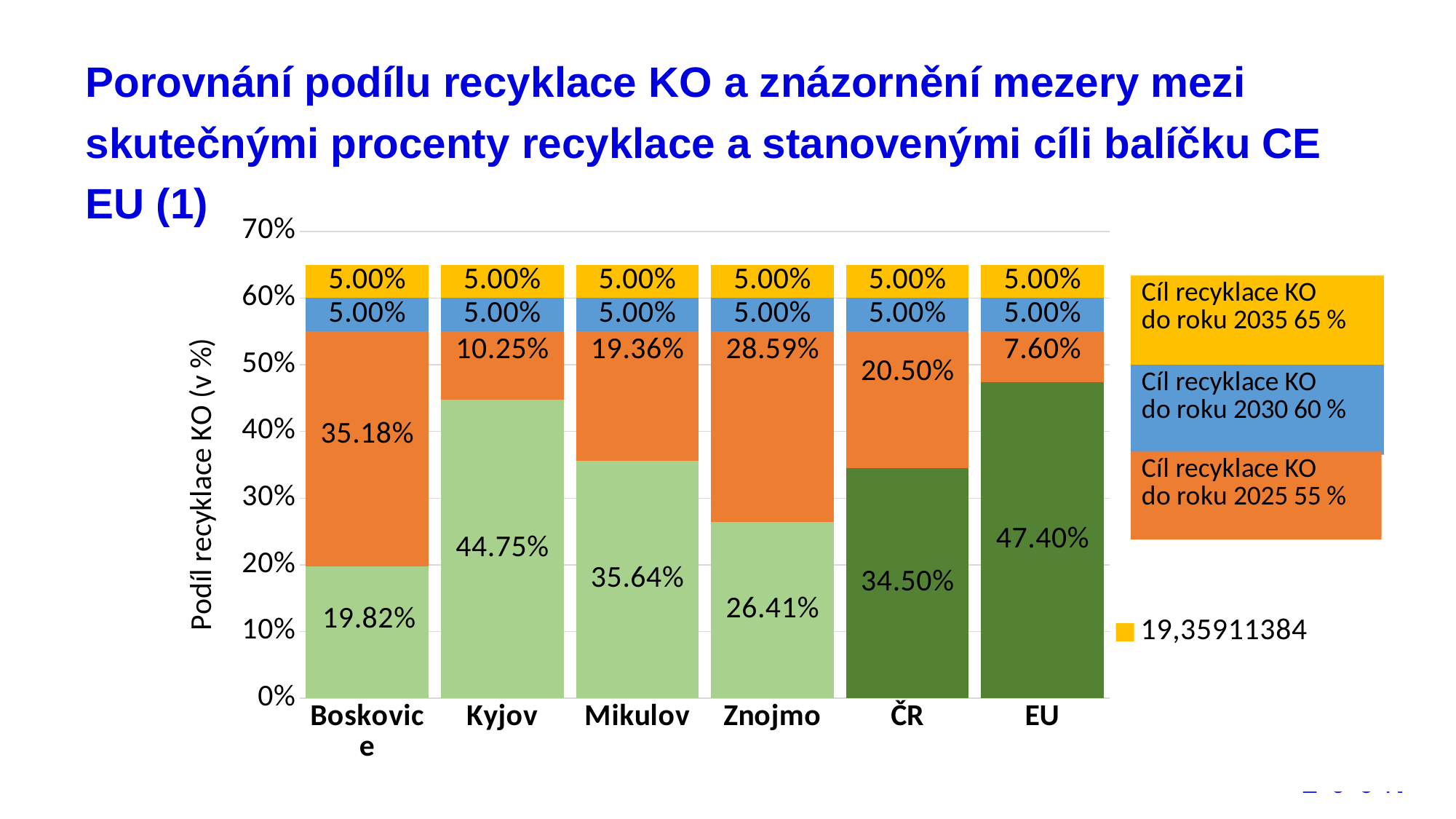
Which has a larger bottom (green) segment value, Znojmo or Mikulov? Mikulov What is the total of the stacked bar for Boskovice? 65.00% Is the bottom (green) segment value for Kyjov greater or less than 40%? greater What is the difference between the bottom (green) segment values of Kyjov and Boskovice? 24.93% What is the value of the orange segment for Znojmo? 28.59% What kind of chart is shown on the slide? Stacked bar chart Which category has the lowest value in the bottom (green) segment? Boskovice Which category has the highest value in the bottom (green) segment? EU What is the value of the bottom (green) segment for Kyjov? 44.75% What is the value of the bottom (green) segment for EU? 47.40% What is the value of the orange segment for ČR? 20.50% How many categories are shown on the x axis? 6